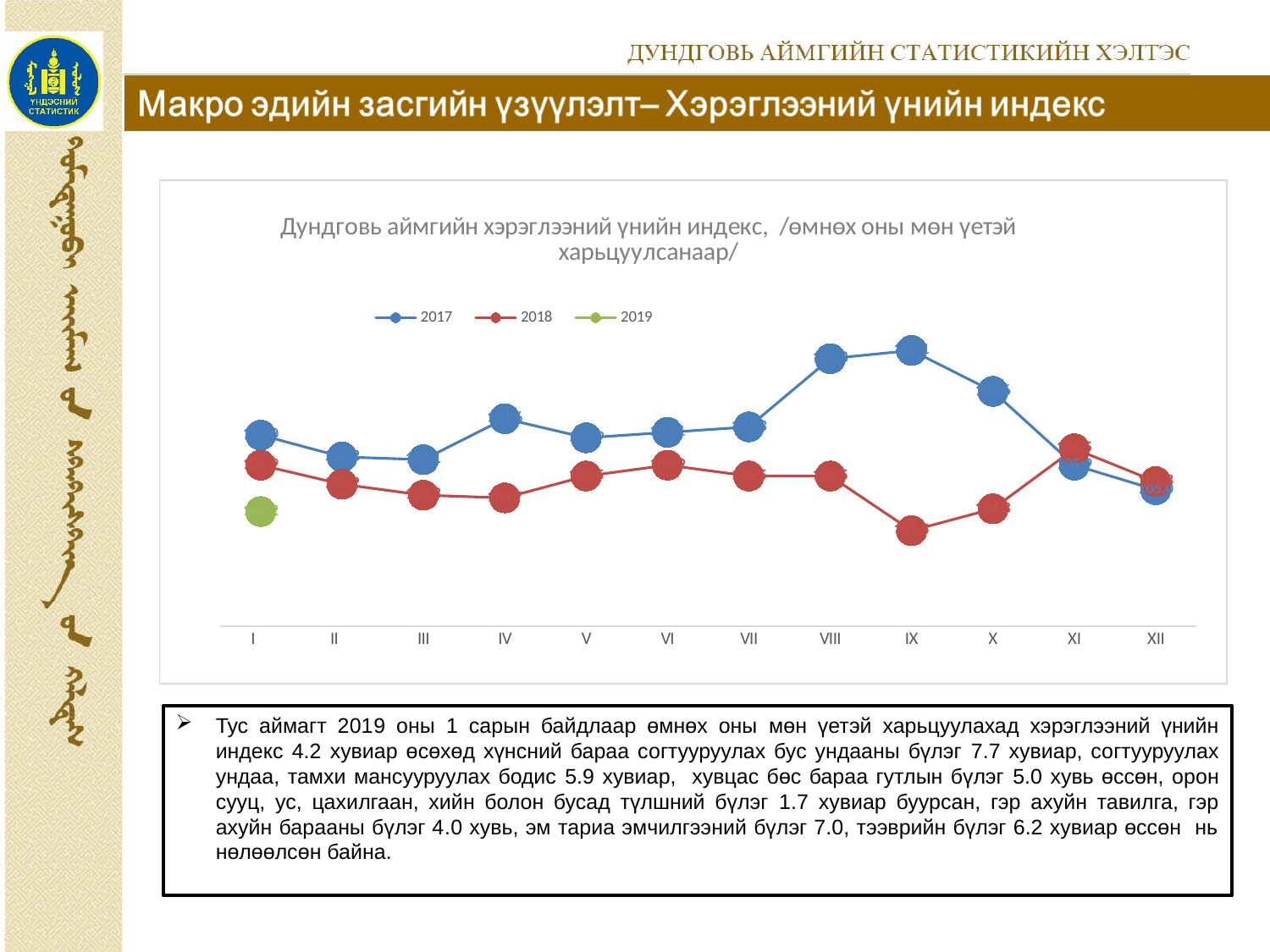
In month I, which series has the higher value, 2017 or 2018? 2017 In which month does the 2018 series reach its lowest point? IX In month I, which series has the lowest value: 2017, 2018 or 2019? 2019 How many data points does the 2019 series have on the chart? 1 How many categories (months) are shown on the x axis of the chart? 12 In which month does the 2018 series reach its highest point? XI Does the 2017 series rise or fall from month IX to month XII? fall In which month does the 2017 series reach its highest point? IX What kind of chart is shown on the slide? line chart How many series does the chart legend list? 3 In month IX, which series has the higher value, 2017 or 2018? 2017 Which years are listed in the chart legend? 2017, 2018, 2019